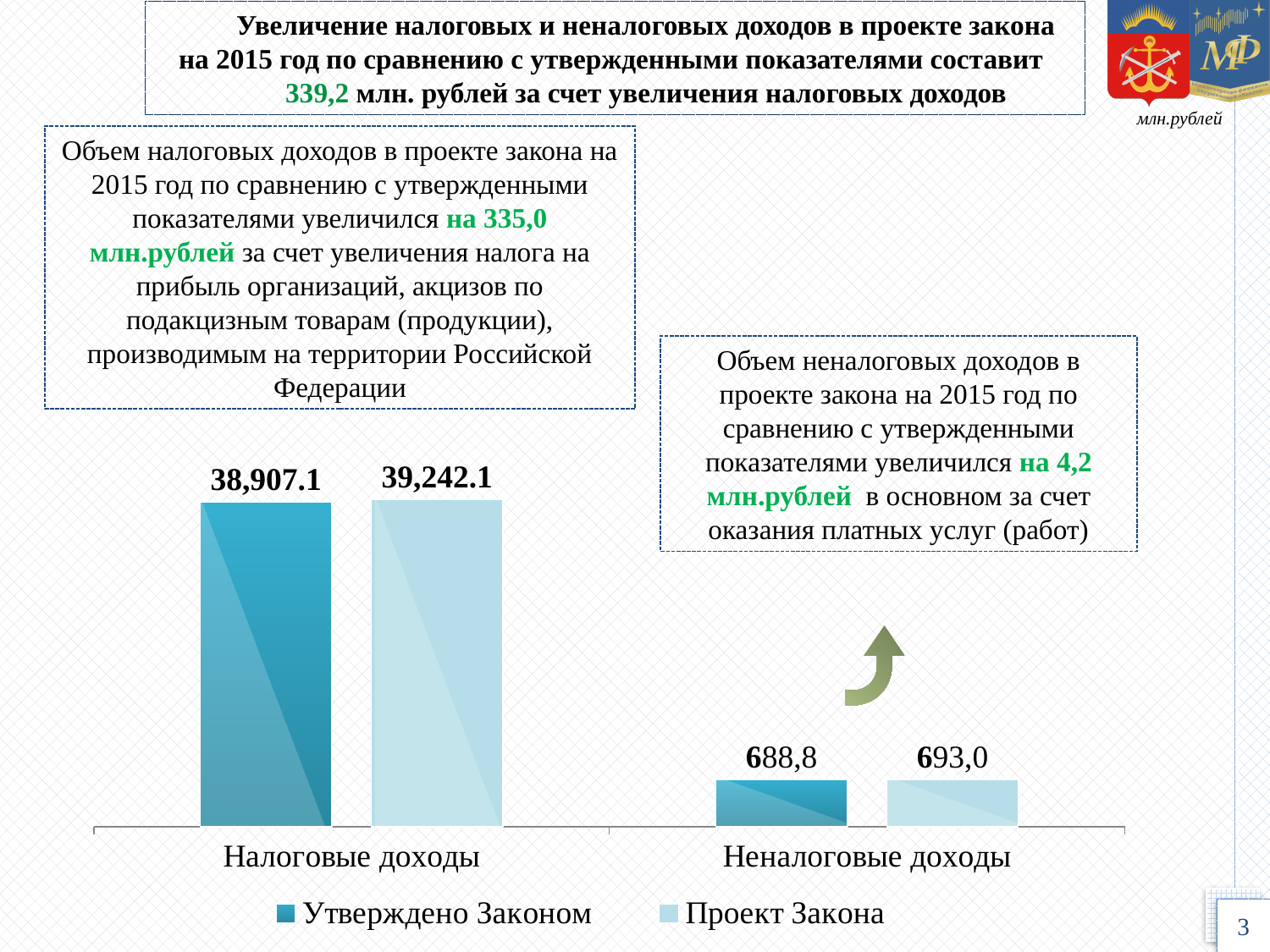
Which category has the highest value in the Проект Закона series? Налоговые доходы What is the difference between the Проект Закона and Утверждено Законом values for Налоговые доходы? 335.0 What is the value for Неналоговые доходы in the Утверждено Законом series? 688,8 How many series does the chart legend list? 2 What is the value for Налоговые доходы in the Проект Закона series? 39,242.1 What type of chart is shown on the slide? Bar chart How many categories are shown on the x axis of the chart? 2 What is the value for Неналоговые доходы in the Проект Закона series? 693,0 For Неналоговые доходы, which is larger: Утверждено Законом or Проект Закона? Проект Закона What is the value for Налоговые доходы in the Утверждено Законом series? 38,907.1 What is the difference between the Проект Закона and Утверждено Законом values for Неналоговые доходы? 4,2 Which category has the lowest value in the Утверждено Законом series? Неналоговые доходы